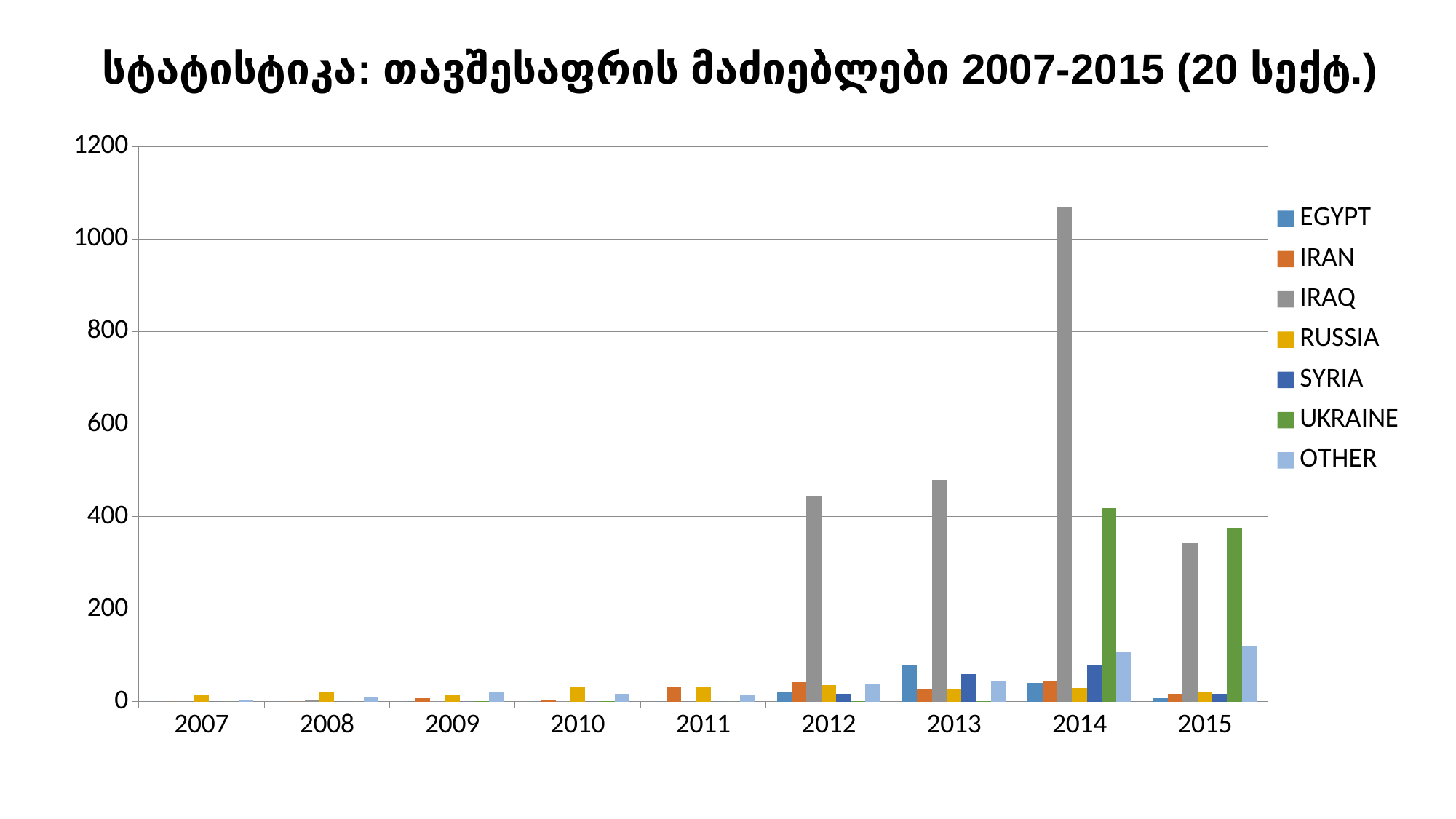
What kind of chart is shown on the slide? bar chart Is the value for IRAQ in 2015 greater or less than 400? less Which is larger, the IRAQ value in 2013 or the IRAQ value in 2015? 2013 Is the value for IRAQ in 2014 greater or less than 1000? greater Which series has the tallest bar in 2014? IRAQ Do the IRAQ values rise or fall from 2012 to 2014? rise In which year is the IRAQ bar the highest? 2014 How many series does the legend list? 7 Is the value for UKRAINE in 2014 greater or less than 200? greater How many years are shown on the x axis? 9 What colour represents UKRAINE in the legend? green